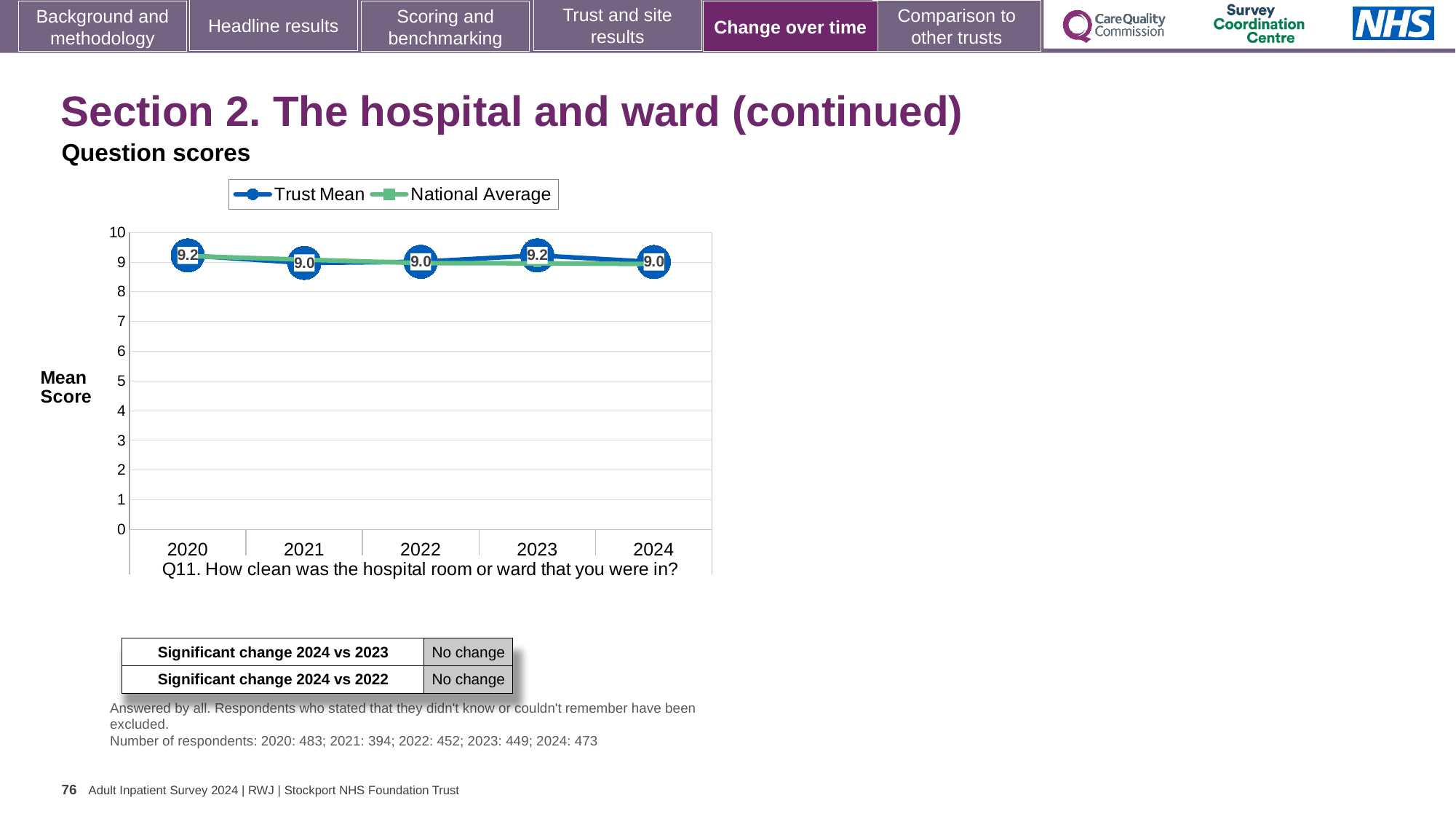
Which year has the larger Trust Mean score, 2023 or 2024? 2023 What is the Trust Mean score for 2020? 9.2 What is the Trust Mean score for 2023? 9.2 What is the difference between the Trust Mean scores for 2020 and 2021? 0.2 Which two series are listed in the chart legend? Trust Mean and National Average How many series does the chart legend list? 2 What kind of chart is shown on the slide? Line chart What is the Trust Mean score for 2021? 9.0 What is the title of the y axis of the chart? Mean Score What is the Trust Mean score for 2024? 9.0 Is the National Average value for 2022 greater or less than 8? greater How many years are shown on the x axis of the chart? 5